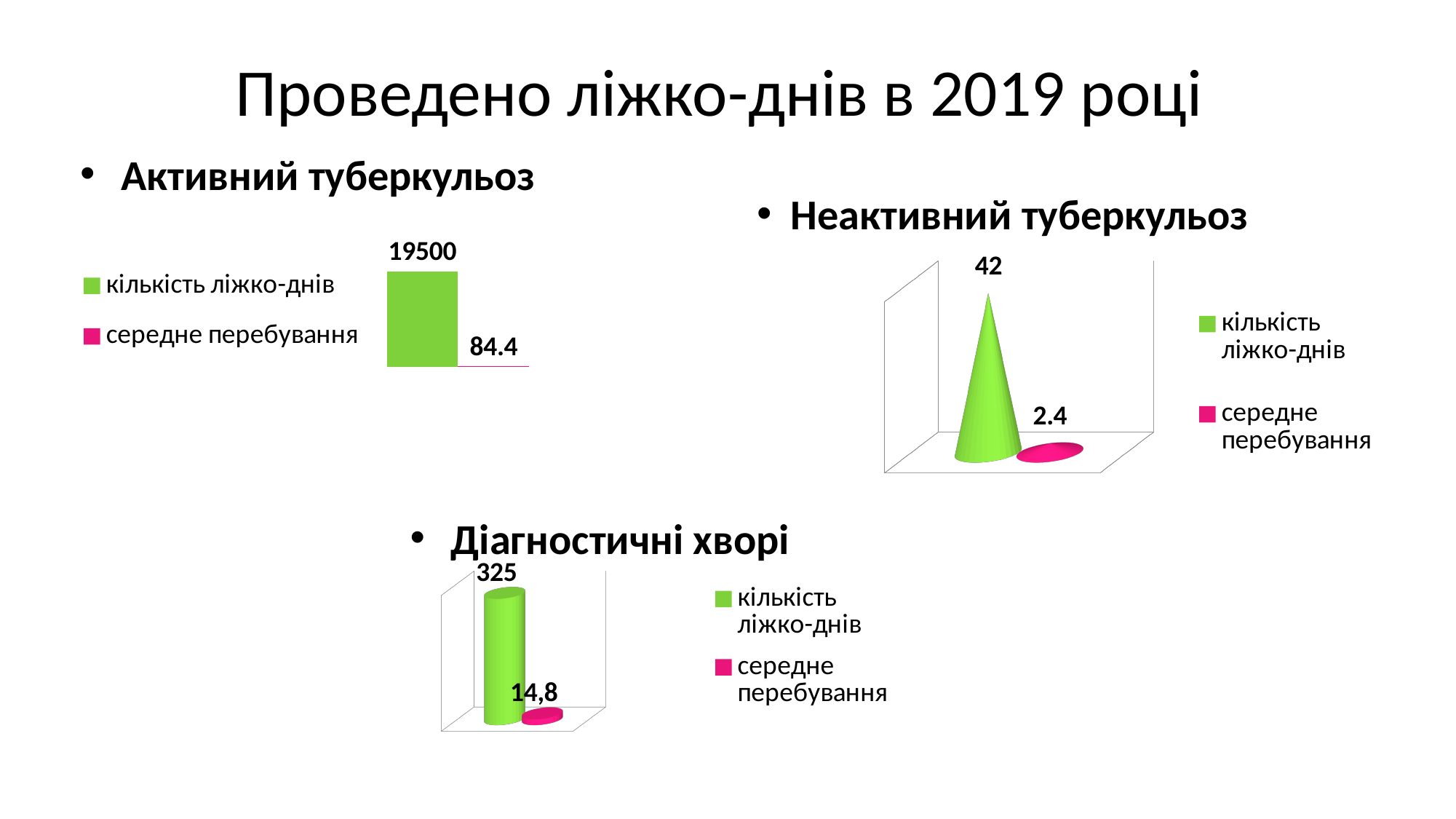
In the 'Активний туберкульоз' chart, what is the value for 'кількість ліжко-днів'? 19500 In the 'Активний туберкульоз' chart, what is the value for 'середнє перебування'? 84.4 In the 'Діагностичні хворі' chart, what is the value for 'середнє перебування'? 14,8 How many series does the legend of the 'Діагностичні хворі' chart list? 2 What kind of chart is the 'Активний туберкульоз' chart? bar chart In the 'Неактивний туберкульоз' chart, which series has the lowest value? середнє перебування In the 'Діагностичні хворі' chart, what is the value for 'кількість ліжко-днів'? 325 In the 'Неактивний туберкульоз' chart, what is the value for 'середнє перебування'? 2.4 In the 'Неактивний туберкульоз' chart, what is the value for 'кількість ліжко-днів'? 42 In the 'Активний туберкульоз' chart, which series has the higher value? кількість ліжко-днів In the 'Діагностичні хворі' chart, which series has the highest value? кількість ліжко-днів In the 'Неактивний туберкульоз' chart, what is the difference between 'кількість ліжко-днів' and 'середнє перебування'? 39.6